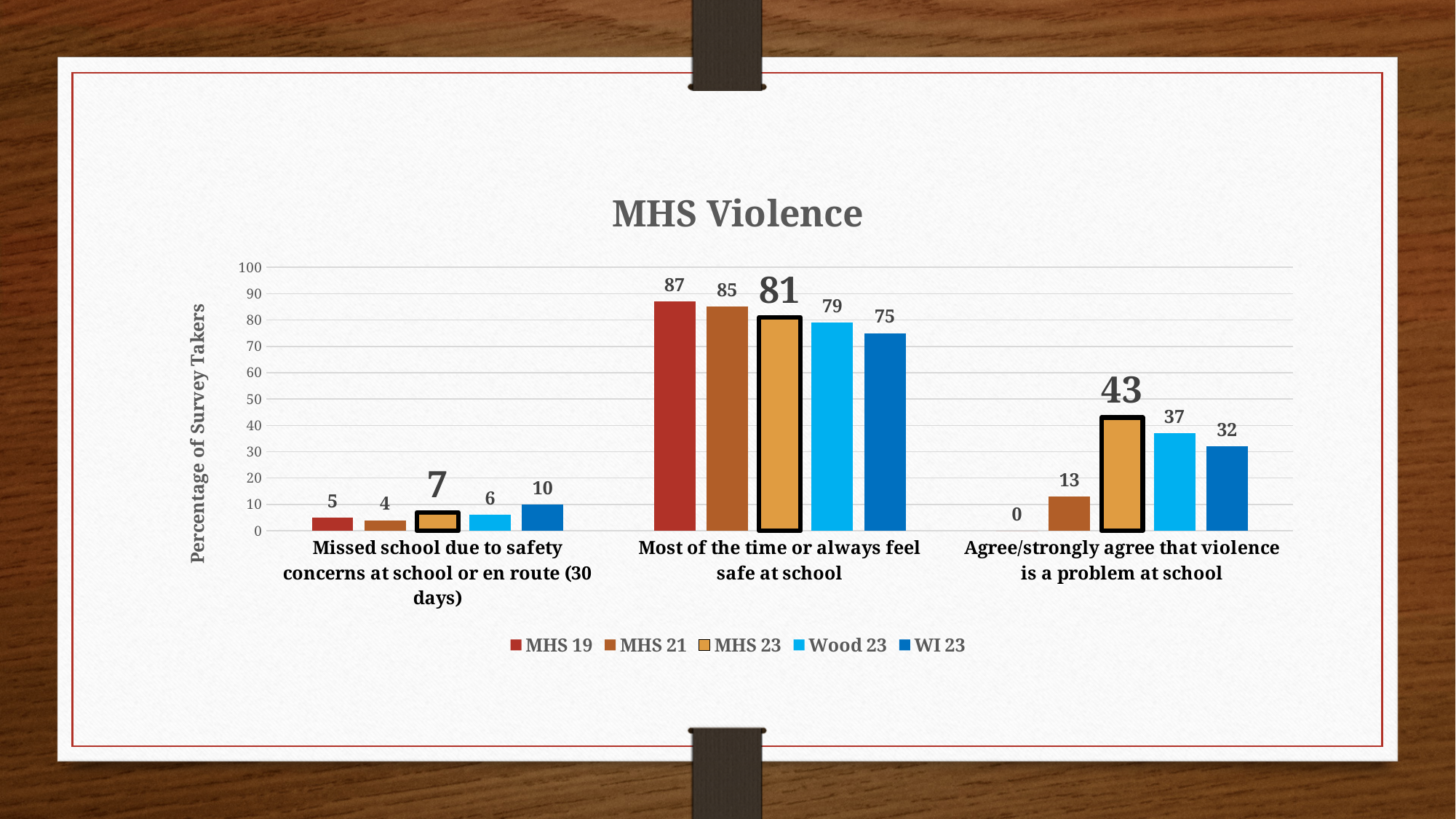
What is the value for MHS 19 in the 'Agree/strongly agree that violence is a problem at school' category? 0 Which series has the highest value in the 'Most of the time or always feel safe at school' category? MHS 19 How many categories are shown on the x axis? 3 How many series does the legend list? 5 What kind of chart is shown on the slide? bar chart Is the value for MHS 21 in the 'Agree/strongly agree that violence is a problem at school' category greater or less than 20? less Which series has the lowest value in the 'Missed school due to safety concerns at school or en route (30 days)' category? MHS 21 Which is larger in the 'Most of the time or always feel safe at school' category: Wood 23 or WI 23? Wood 23 What is the value for WI 23 in the 'Missed school due to safety concerns at school or en route (30 days)' category? 10 What is the title of the chart? MHS Violence What is the difference between the MHS 23 and Wood 23 values in the 'Agree/strongly agree that violence is a problem at school' category? 6 What is the value for MHS 23 in the 'Most of the time or always feel safe at school' category? 81